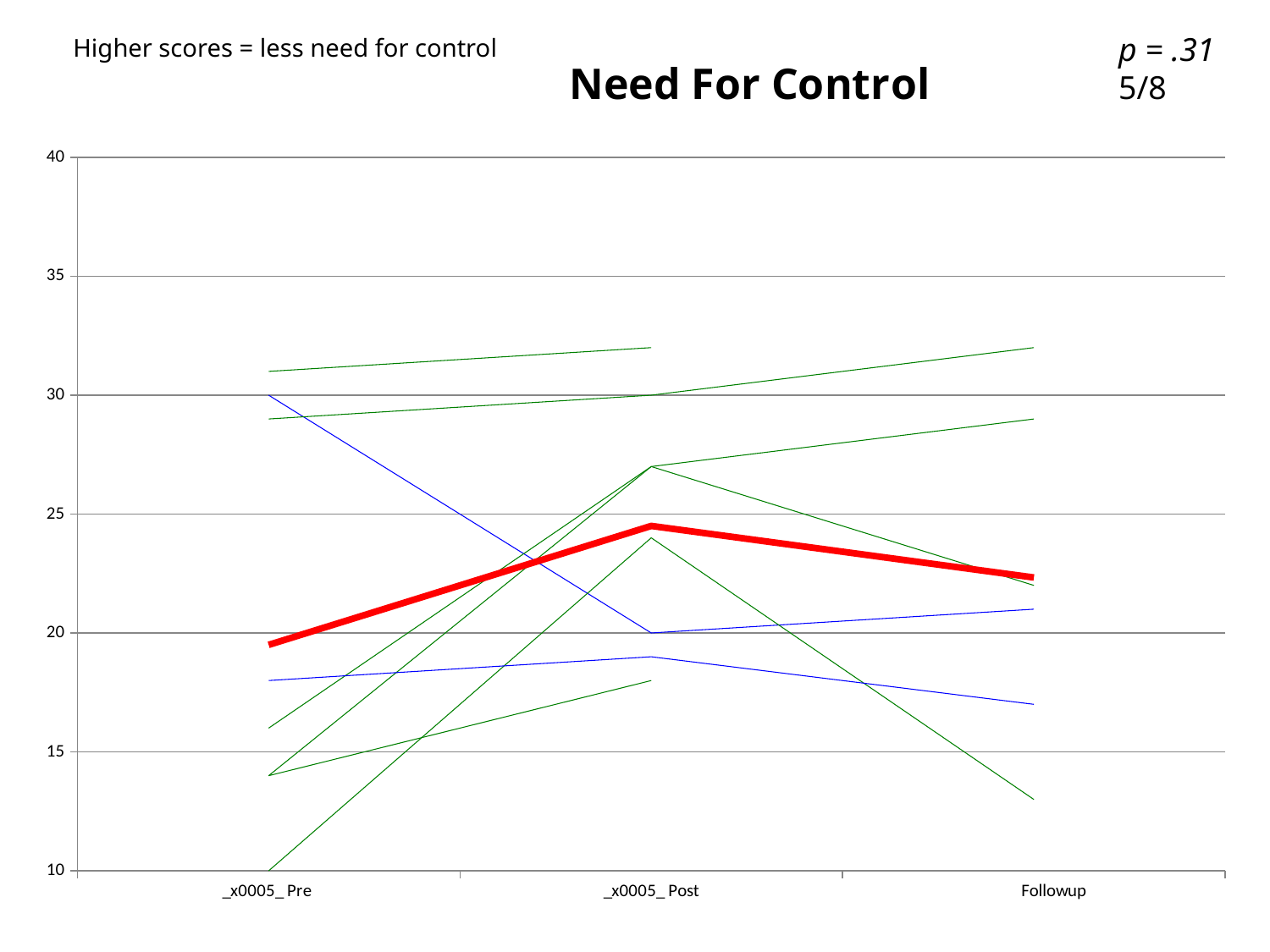
At which x-axis category does the thick red line have its lowest value? _x0005_ Pre What p value is shown on the slide? p = .31 Does the thick red line rise or fall from _x0005_ Pre to _x0005_ Post? rise At which x-axis category does the thick red line reach its highest value? _x0005_ Post Is the value of the thick red line at _x0005_ Post greater or less than 20? greater How many categories are shown on the x axis? 3 What is the title of the chart? Need For Control What kind of chart is shown on the slide? line chart Is the value of the thick red line at _x0005_ Pre greater or less than 25? less Is the value of the thick red line at Followup greater or less than 20? greater Does the thick red line rise or fall from _x0005_ Post to Followup? fall